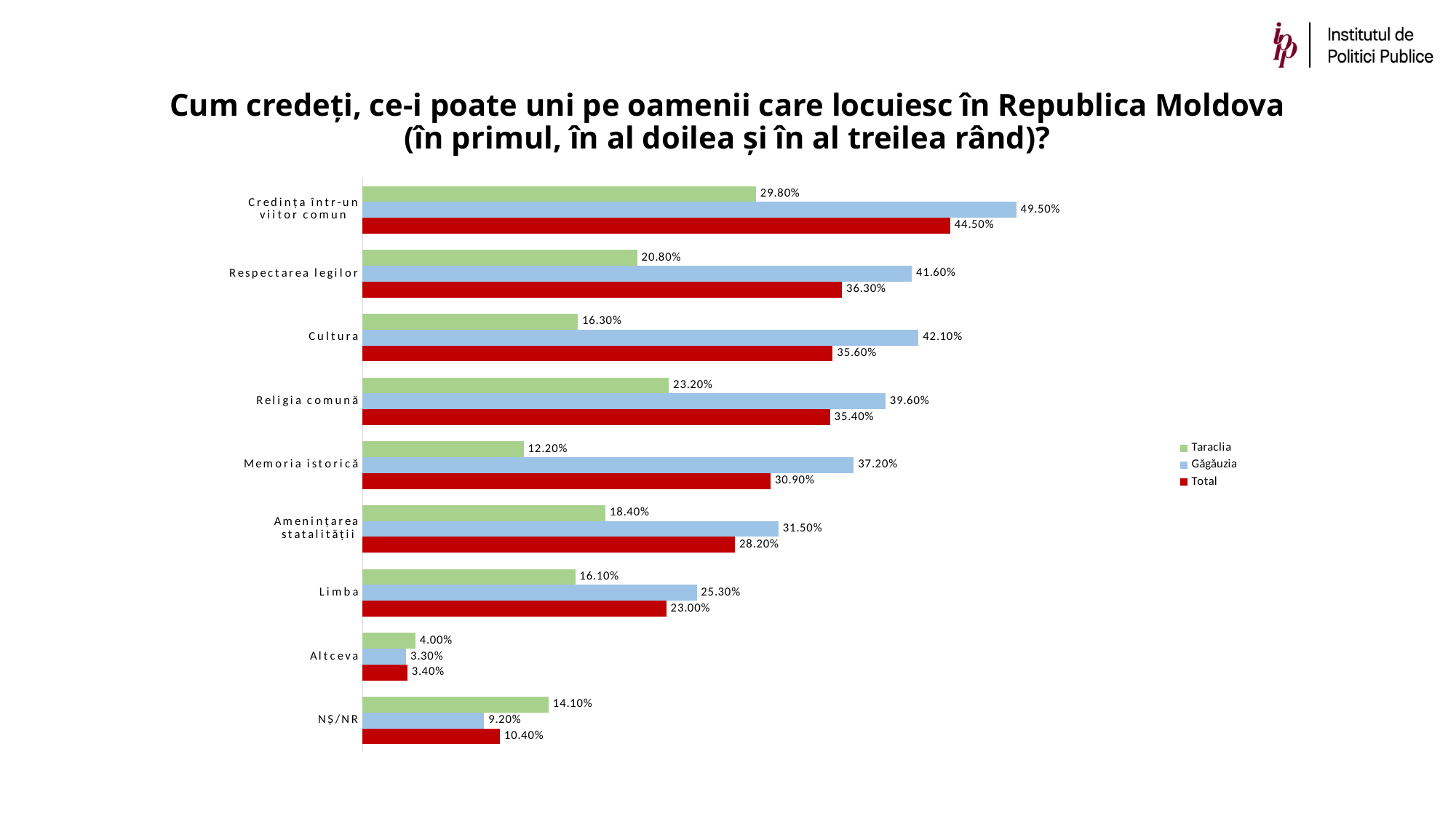
What is the difference between the Total values for Respectarea legilor and Memoria istorică? 5.40% What is the Taraclia value for Memoria istorică? 12.20% How many categories are shown on the chart? 9 How many series does the legend list? 3 What kind of chart is shown on the slide? Bar chart Which is larger for Religia comună: the Taraclia value or the Total value? Total What is the difference between the Găgăuzia and Taraclia values for Cultura? 25.80% Which category has the highest Total value? Credința într-un viitor comun Which series is shown in red in the legend? Total What is the Găgăuzia value for Credința într-un viitor comun? 49.50% Which category has the lowest Găgăuzia value? Altceva What is the Total value for Limba? 23.00%